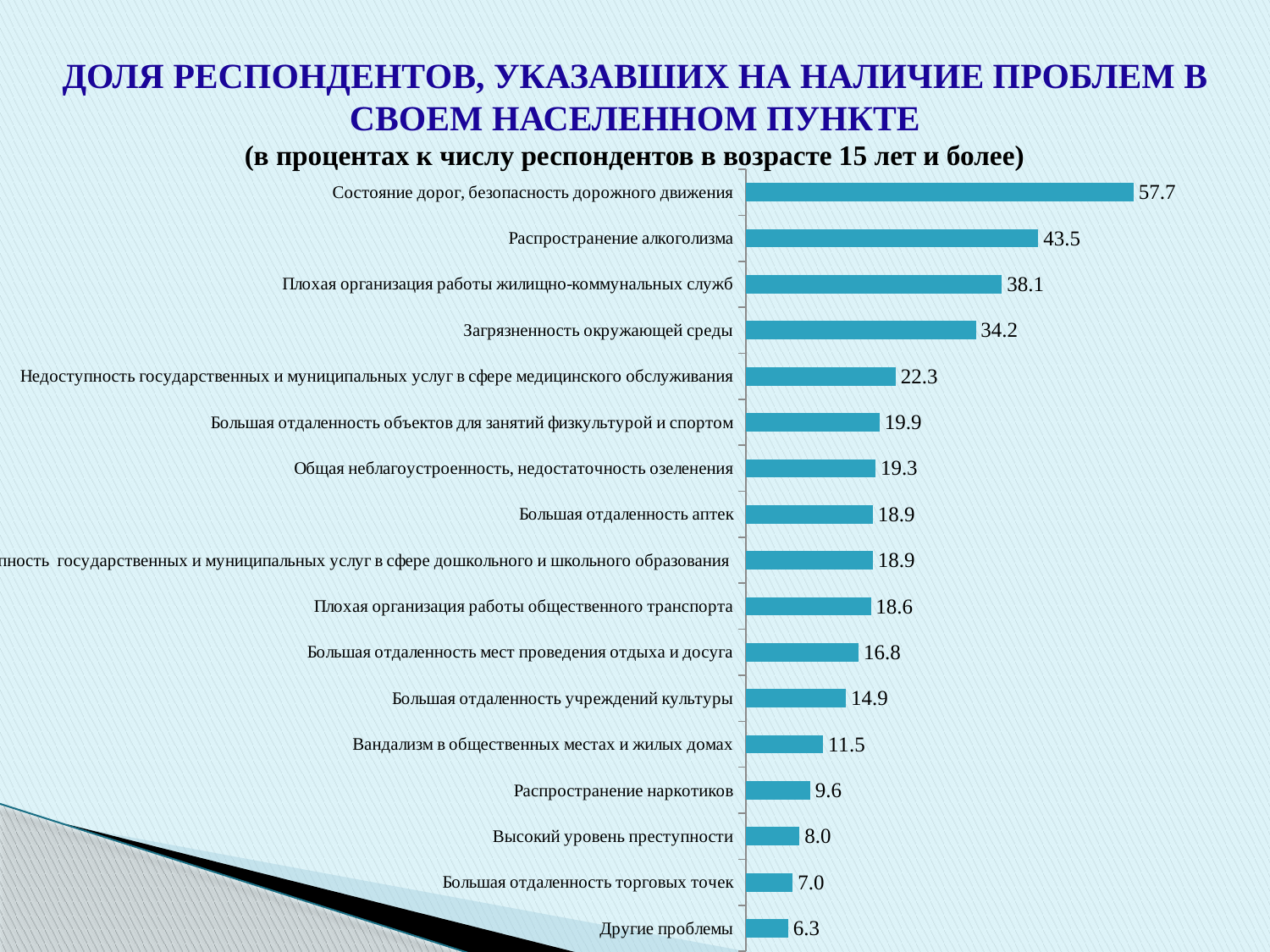
Which category has the lowest value? Другие проблемы What is the value for "Состояние дорог, безопасность дорожного движения"? 57.7 What is the difference between the values for "Распространение наркотиков" and "Высокий уровень преступности"? 1.6 What is the value for "Загрязненность окружающей среды"? 34.2 Which is larger: the value for "Большая отдаленность учреждений культуры" or the value for "Большая отдаленность мест проведения отдыха и досуга"? Большая отдаленность мест проведения отдыха и досуга What is the value for "Распространение алкоголизма"? 43.5 Which category has the highest value? Состояние дорог, безопасность дорожного движения What is the value for "Большая отдаленность торговых точек"? 7.0 What is the value for "Вандализм в общественных местах и жилых домах"? 11.5 What kind of chart is shown on the slide? Bar chart What is the difference between the values for "Распространение алкоголизма" and "Плохая организация работы жилищно-коммунальных служб"? 5.4 How many categories are shown in the chart? 17